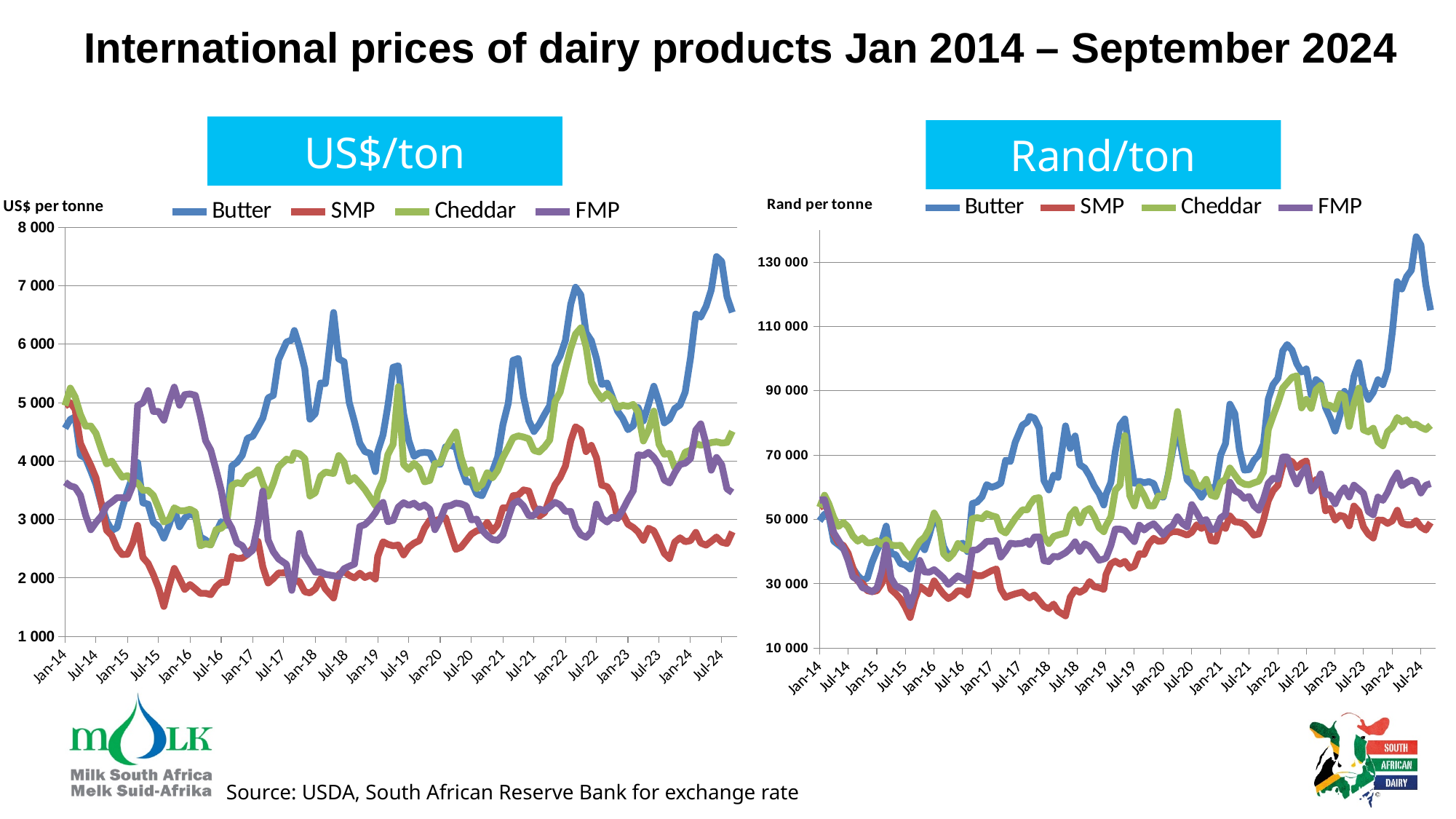
In the Rand/ton chart, is the peak value of the Butter series greater or less than 130 000? greater In the US$/ton chart, is the lowest value of the SMP series greater or less than 2 000? less In the US$/ton chart, is the peak value of the Butter series greater or less than 7 000? greater How many series does the legend of the US$/ton chart list? 4 In the US$/ton chart, at Jul-24 which is larger, Butter or SMP? Butter In the Rand/ton chart, does the Butter series overall rise or fall from Jan-14 to Jul-24? rise What is the vertical axis label of the US$/ton chart? US$ per tonne In the Rand/ton chart, at Jul-24 which is larger, Cheddar or FMP? Cheddar In the US$/ton chart, which series reaches the highest value over the whole period? Butter What kind of chart is the US$/ton chart? line chart In the US$/ton chart, which series reaches the lowest value over the whole period? SMP How many series does the legend of the Rand/ton chart list? 4